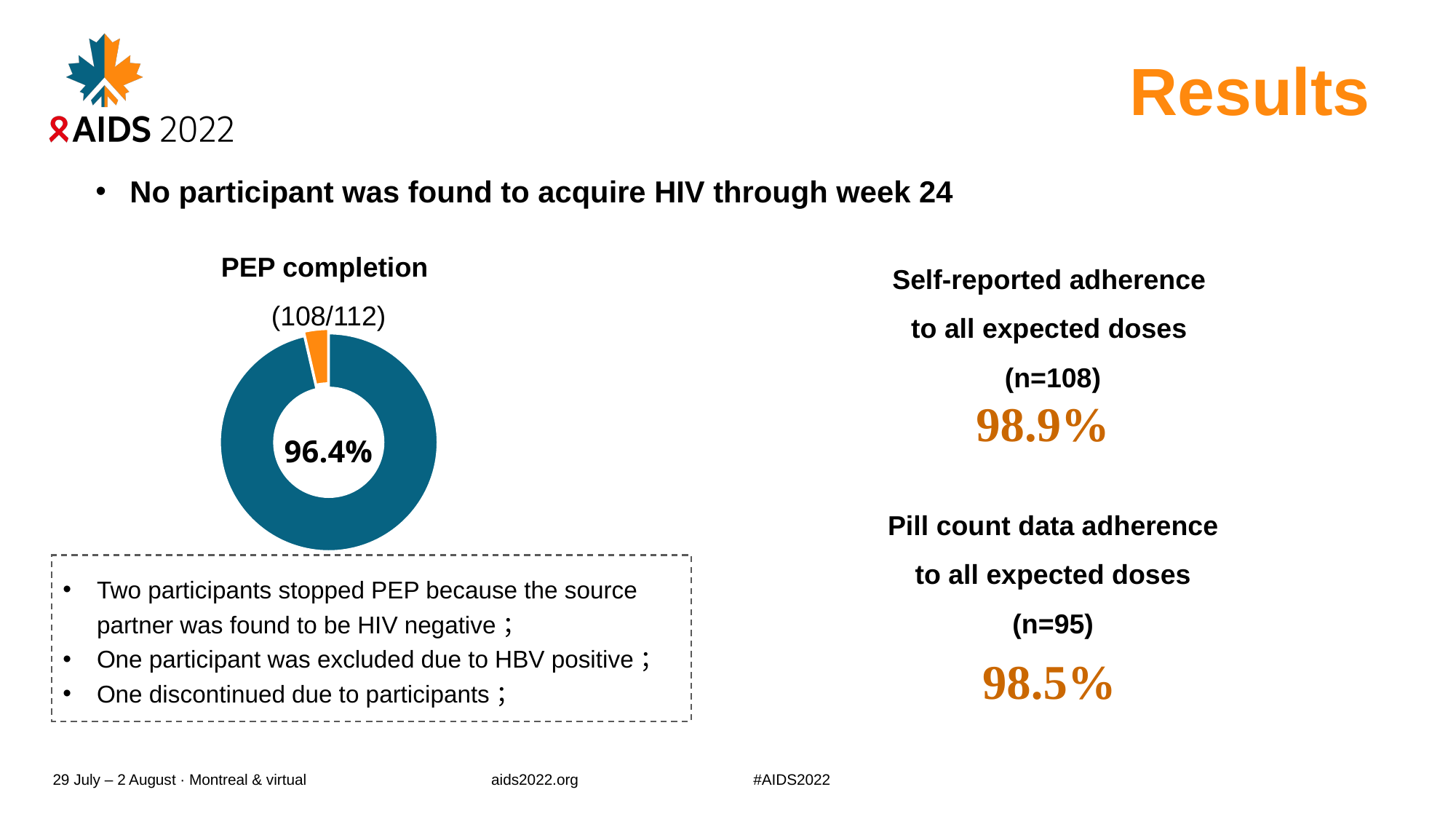
What is the title of the chart on the slide? PEP completion Is the PEP completion rate shown in the chart greater or less than 90%? greater What share of the PEP completion chart does the large blue slice represent? 96.4% What kind of chart is shown under the title "PEP completion"? Pie (donut) chart What fraction is shown above the PEP completion chart? 108/112 Out of how many participants did 108 complete PEP, according to the chart label? 112 What percentage is printed in the centre of the PEP completion chart? 96.4% What colour is the small slice in the PEP completion chart? Orange In the PEP completion chart, which slice is larger, the blue one or the orange one? The blue one How many slices does the PEP completion chart have? 2